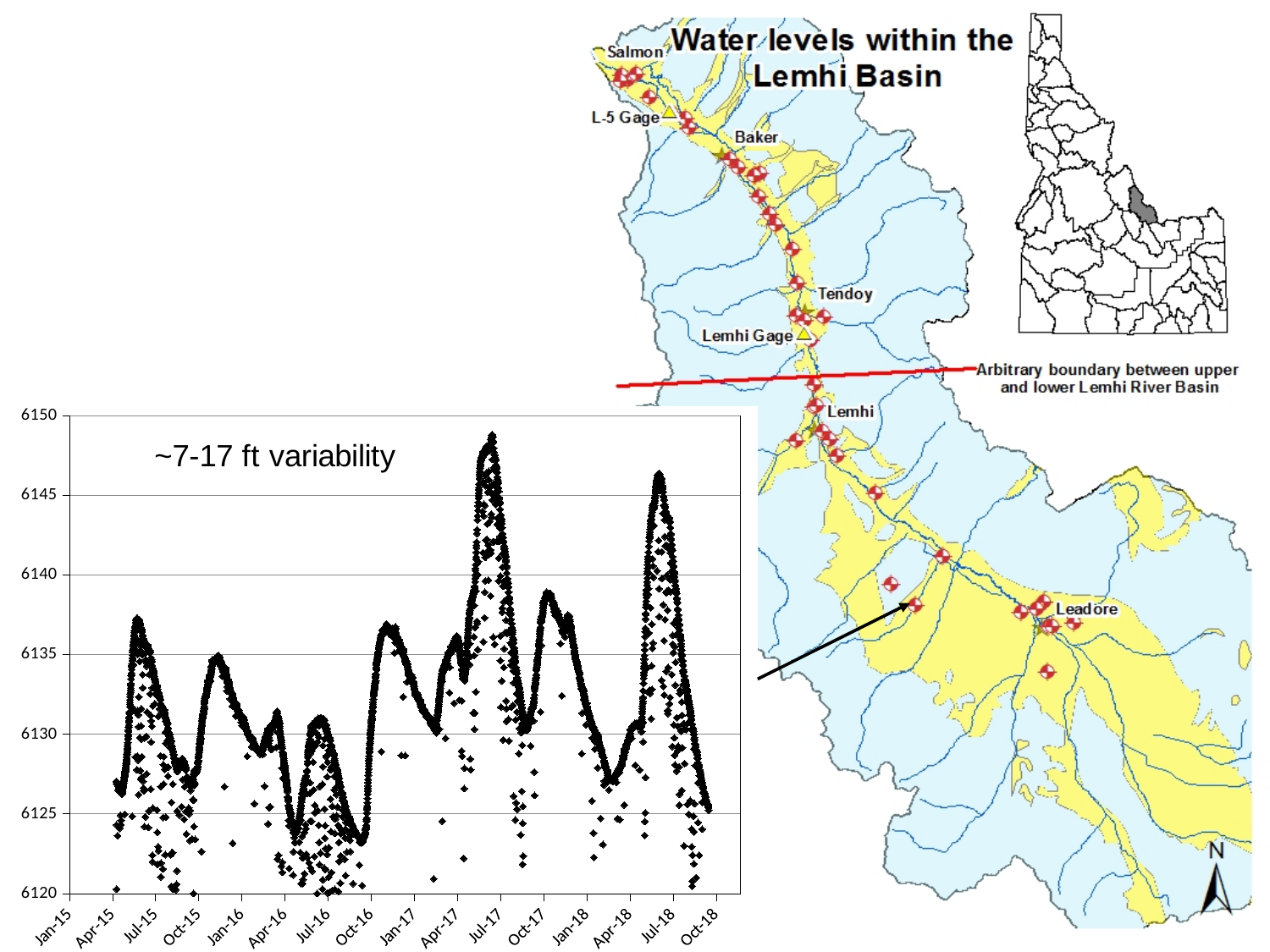
Is the peak water level near Jul-15 greater or less than 6140? less Is the peak water level near Jul-17 greater or less than 6145? greater How many tick labels are shown on the x axis of the water level chart? 16 What kind of chart is shown on the left of the slide? scatter chart What is the highest value shown on the y axis of the water level chart? 6150 Which peak is higher on the water level chart, the one near Jul-17 or the one near Jul-15? Jul-17 Which peak is lower on the water level chart, the one near Jul-16 or the one near Jul-18? Jul-16 What is the lowest value shown on the y axis of the water level chart? 6120 Is the peak water level near Jul-18 greater or less than 6140? greater Around which x-axis tick does the water level chart reach its highest peak? Jul-17 What variability is stated in the annotation on the water level chart? ~7-17 ft variability